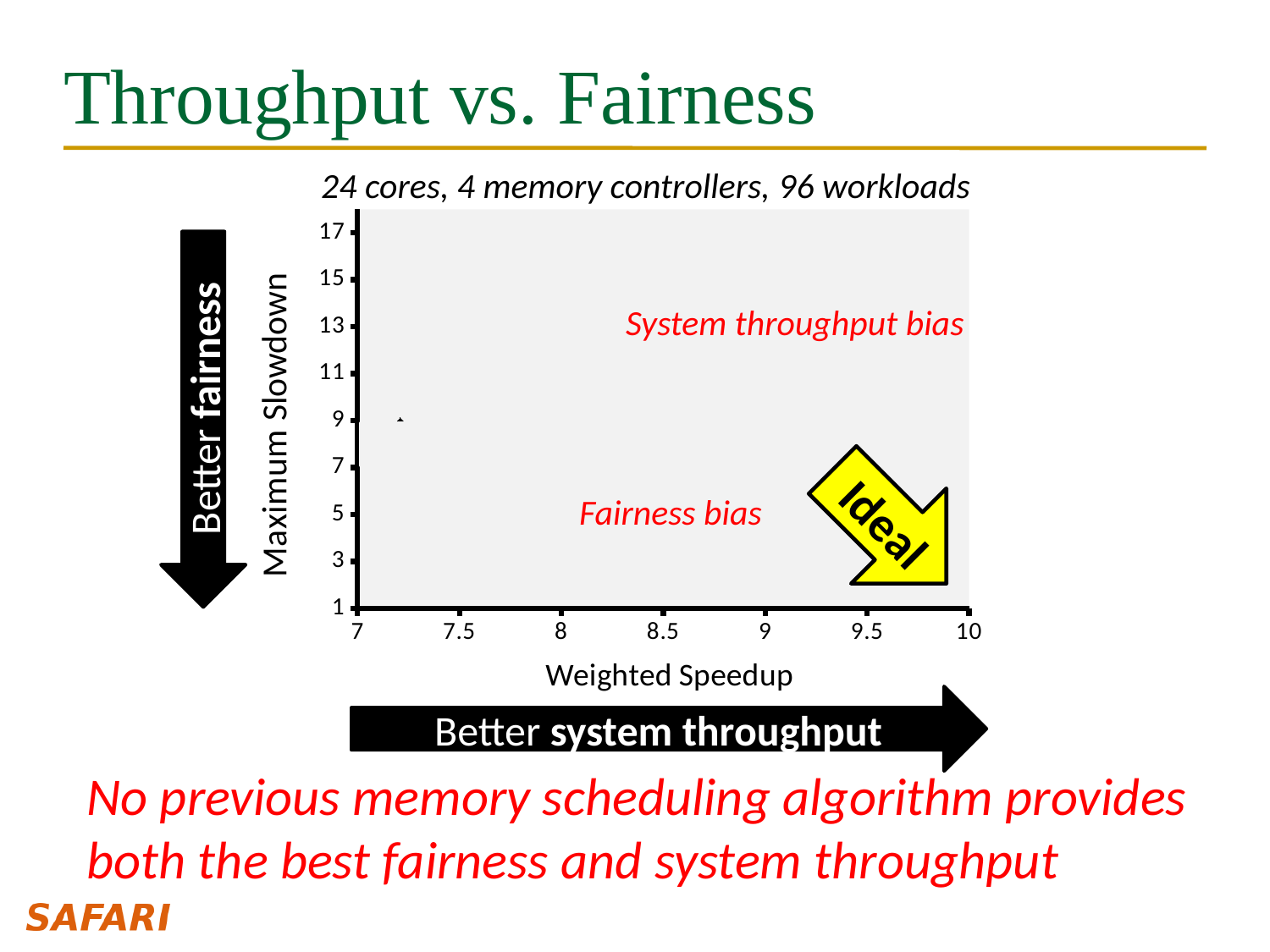
Is the Weighted Speedup of the plotted point greater or less than 9? less What text appears as the title directly above the chart? 24 cores, 4 memory controllers, 96 workloads How many data points are plotted on the chart? 1 What is the label of the x axis of the chart? Weighted Speedup Is the Maximum Slowdown of the plotted point greater or less than 5? greater Is the Weighted Speedup of the plotted point greater or less than 8? less What kind of chart is shown on the slide? scatter chart